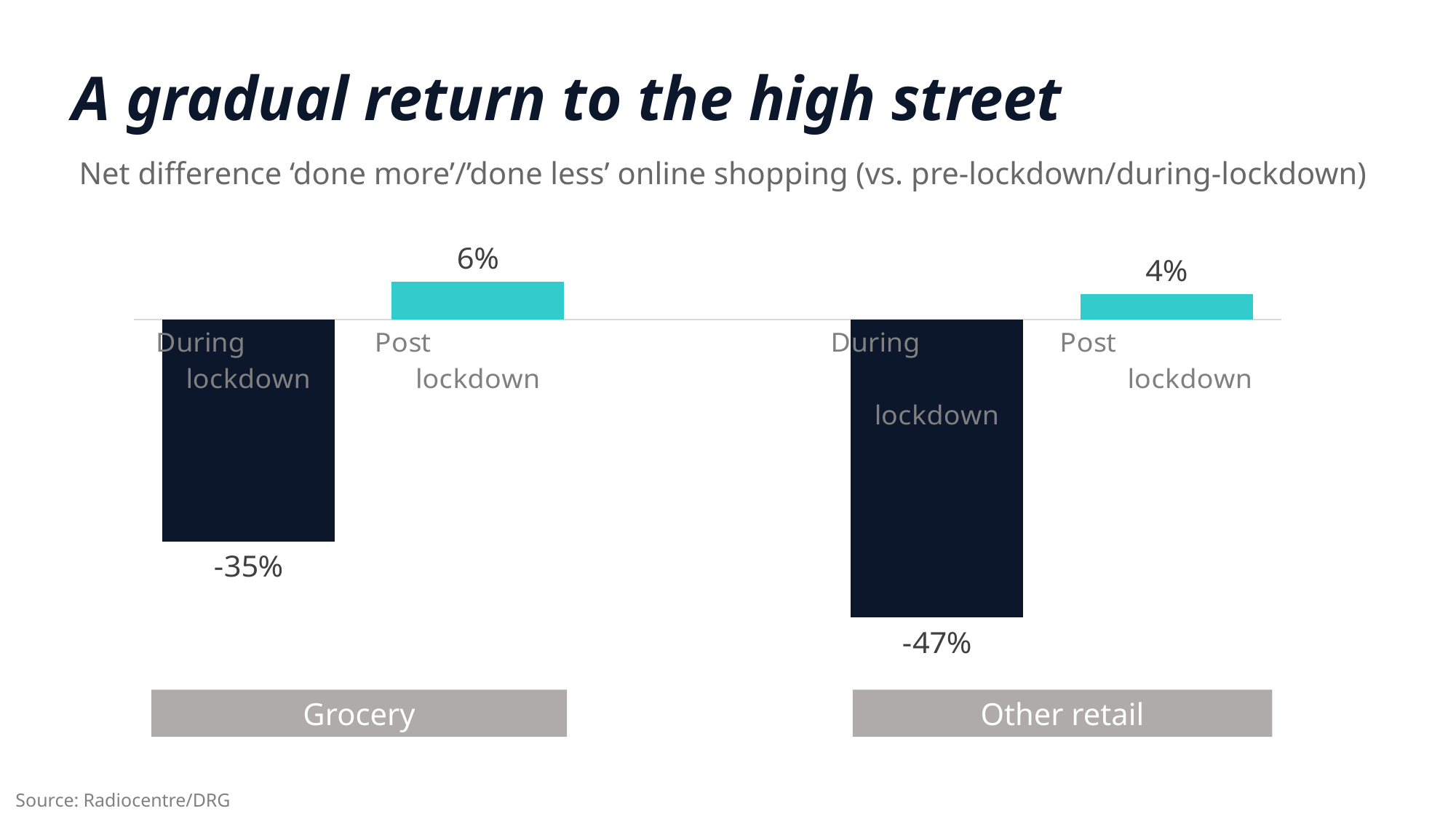
What is the value for Other retail post lockdown? 4% Which bar has the lowest value? Other retail, during lockdown What is the value for Other retail during lockdown? -47% What is the value for Grocery during lockdown? -35% What is the difference between the Grocery post lockdown value and the Grocery during lockdown value? 41 percentage points What kind of chart is shown on the slide? Bar chart What is the source cited for the chart? Radiocentre/DRG Which is larger, the post lockdown value for Grocery or for Other retail? Grocery What is the value for Grocery post lockdown? 6% Which bar has the highest value? Grocery, post lockdown What is the difference between the Other retail post lockdown value and the Other retail during lockdown value? 51 percentage points How many bars are plotted on the chart? 4